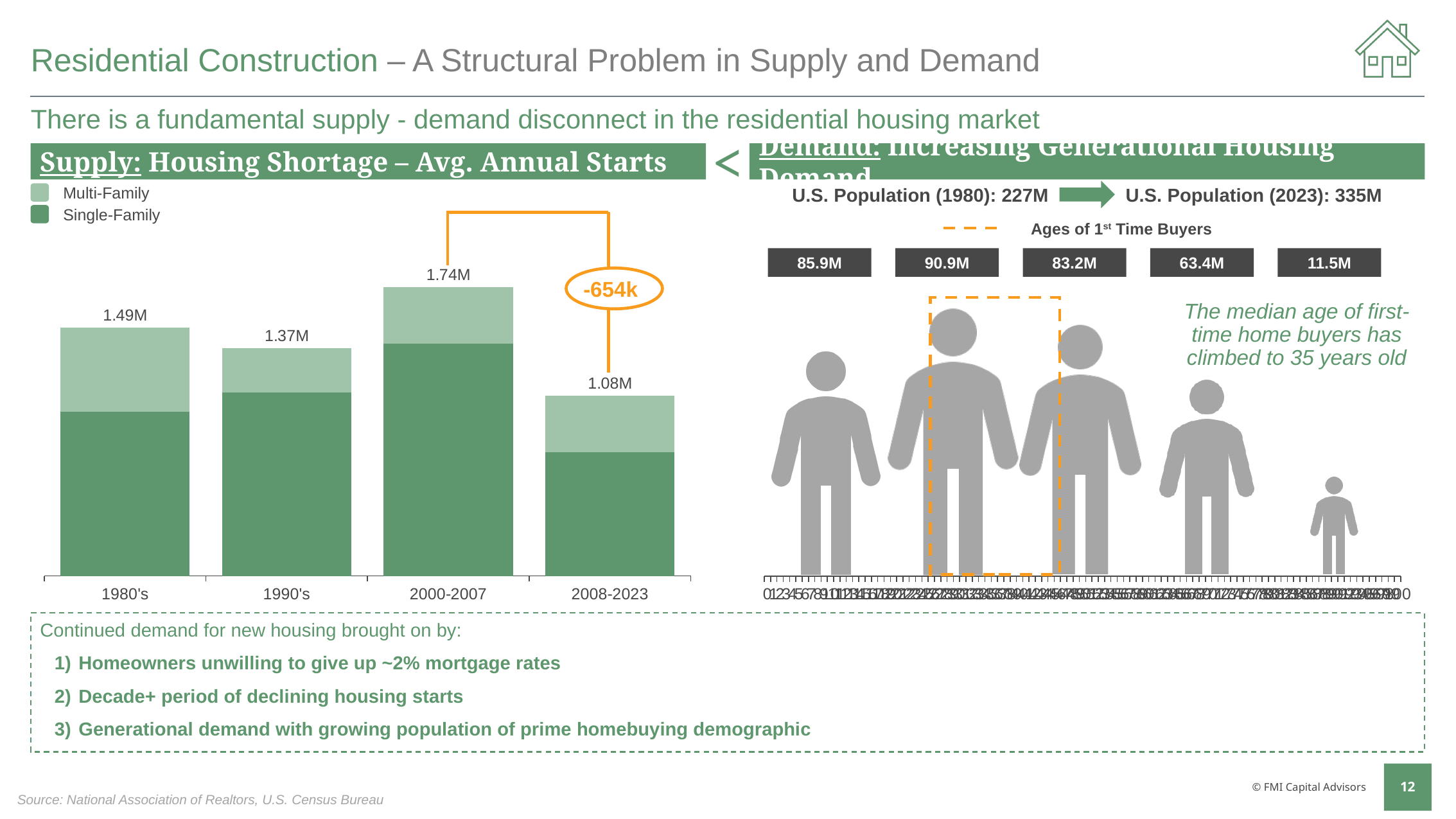
In the Supply chart on the left, how many time periods are shown on the x axis? 4 In the Supply chart on the left, how many series does the legend list? 2 In the Supply chart on the left, which period has a larger total: the 1980's or the 1990's? 1980's In the Supply chart on the left, what is the total average annual starts for 2008-2023? 1.08M In the Supply chart on the left, what are the two series named in the legend? Multi-Family and Single-Family In the Supply chart on the left, which period has the lowest total average annual starts? 2008-2023 In the Supply chart on the left, what is the total average annual starts for the 1980's? 1.49M In the Supply chart on the left, do total starts rise or fall from 2000-2007 to 2008-2023? Fall In the Supply chart on the left, what is the difference between the totals for the 1980's and the 1990's? 0.12M In the Supply chart on the left, which period has the highest total average annual starts? 2000-2007 In the Supply chart on the left, what is the total average annual starts for 2000-2007? 1.74M What kind of chart is the Supply chart on the left? Stacked bar chart